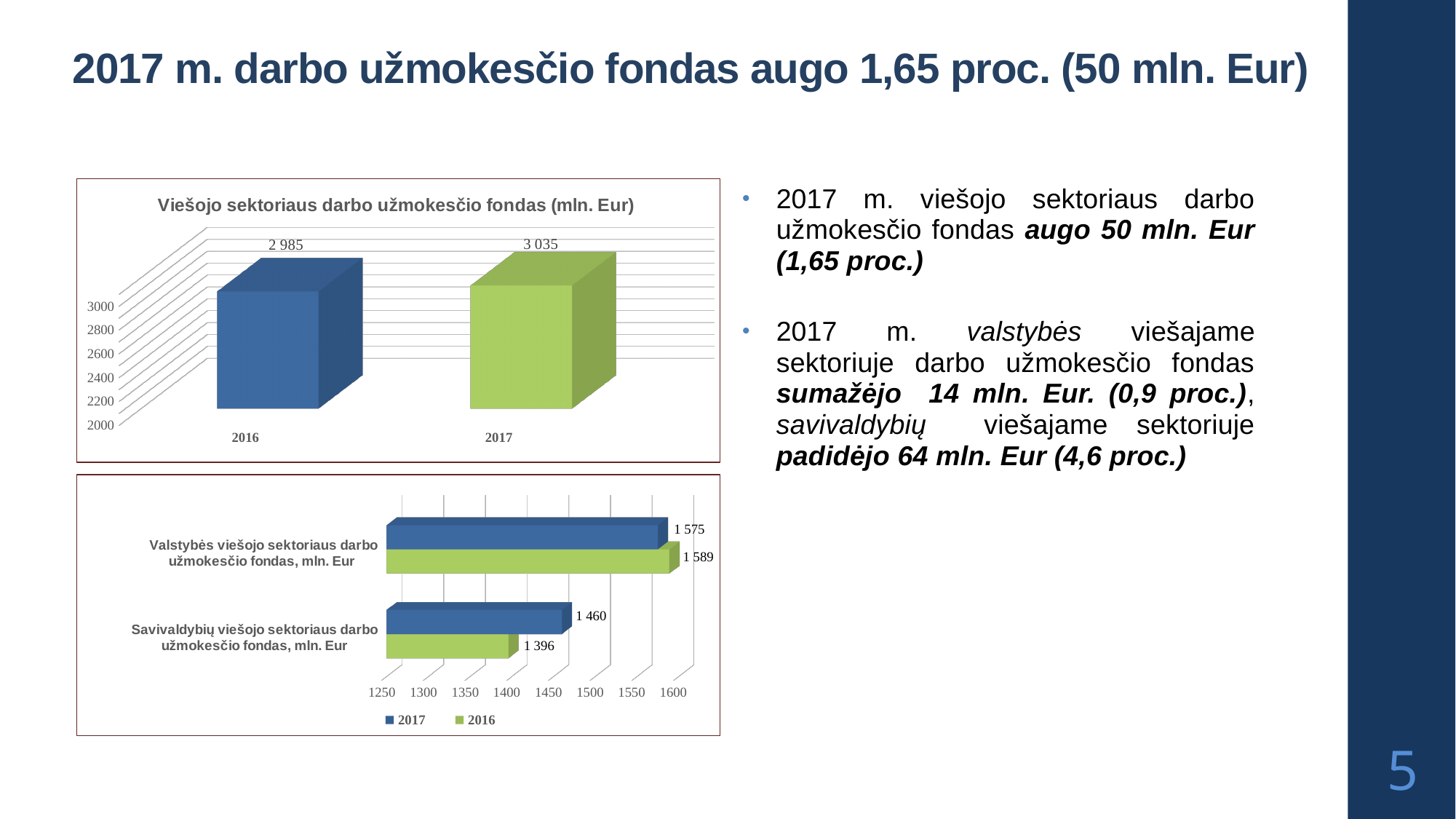
In the top chart 'Viešojo sektoriaus darbo užmokesčio fondas (mln. Eur)', what is the value for 2017? 3 035 In the bottom chart, what is the 2016 value for 'Savivaldybių viešojo sektoriaus darbo užmokesčio fondas, mln. Eur'? 1 396 In the bottom chart, which colour represents the 2016 series? green How many series does the legend of the bottom chart list? 2 In the bottom chart, what is the 2017 value for 'Valstybės viešojo sektoriaus darbo užmokesčio fondas, mln. Eur'? 1 575 How many categories are shown in the bottom chart? 2 In the top chart 'Viešojo sektoriaus darbo užmokesčio fondas (mln. Eur)', do the values rise or fall from 2016 to 2017? rise In the top chart 'Viešojo sektoriaus darbo užmokesčio fondas (mln. Eur)', what is the value for 2016? 2 985 In the bottom chart, what is the difference between the 2016 and 2017 values for 'Valstybės viešojo sektoriaus darbo užmokesčio fondas, mln. Eur'? 14 What kind of chart is the top chart on the slide? bar chart In the top chart 'Viešojo sektoriaus darbo užmokesčio fondas (mln. Eur)', what is the difference between the 2017 and 2016 values? 50 In the bottom chart, which is larger for 'Savivaldybių viešojo sektoriaus darbo užmokesčio fondas, mln. Eur': the 2017 value or the 2016 value? 2017